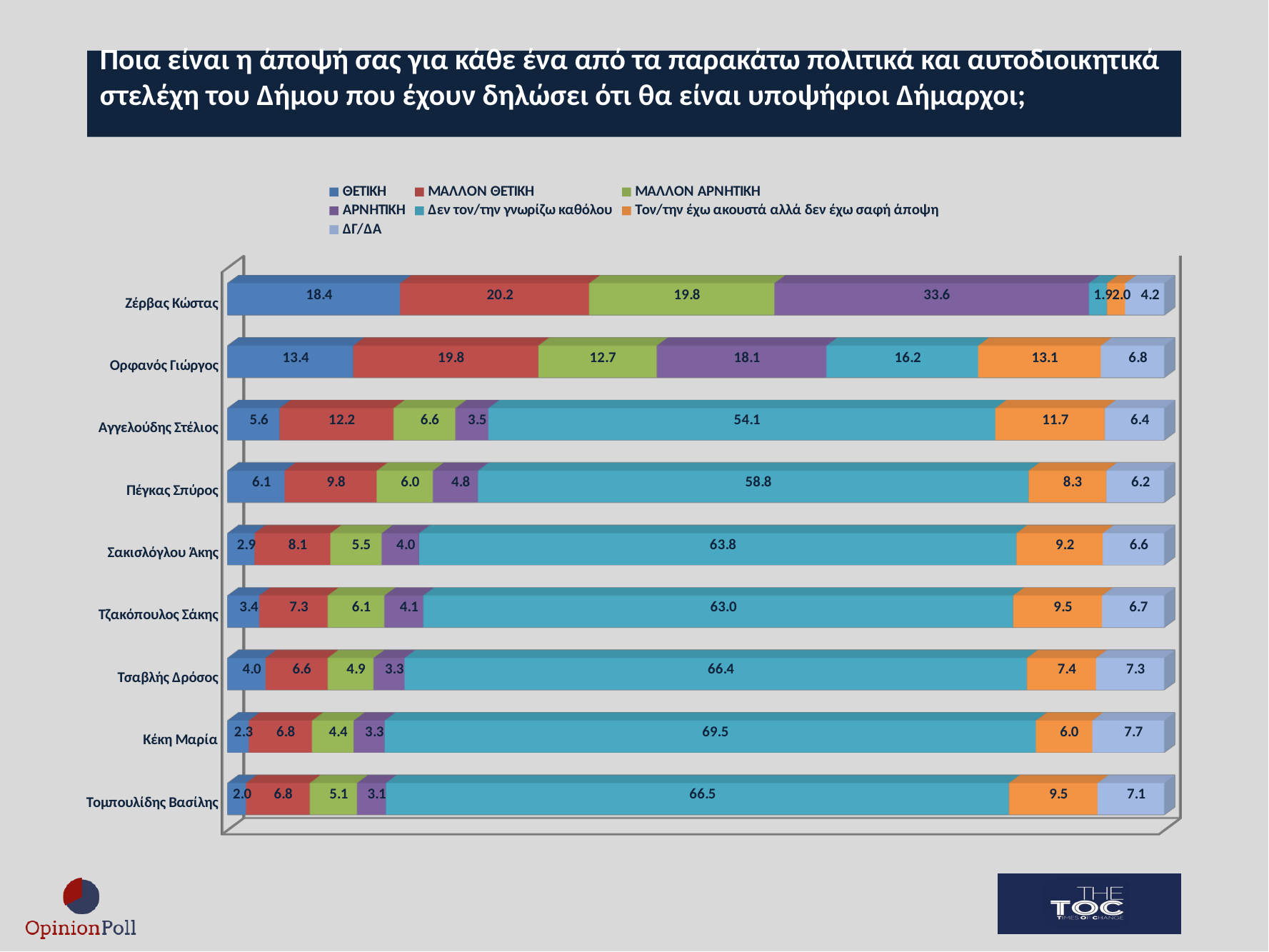
Which is larger: the ΜΑΛΛΟΝ ΘΕΤΙΚΗ value for Αγγελούδης Στέλιος or for Πέγκας Σπύρος? Αγγελούδης Στέλιος Which candidate has the highest ΘΕΤΙΚΗ value? Ζέρβας Κώστας How many series does the legend list? 7 Which candidate has the lowest ΘΕΤΙΚΗ value? Τομπουλίδης Βασίλης What is the ΘΕΤΙΚΗ value for Ζέρβας Κώστας? 18.4 What is the difference between the ΑΡΝΗΤΙΚΗ values for Ζέρβας Κώστας and Ορφανός Γιώργος? 15.5 Which colour represents the ΔΓ/ΔΑ series in the legend? Light blue What kind of chart is shown on the slide? Stacked bar chart What is the 'Δεν τον/την γνωρίζω καθόλου' value for Πέγκας Σπύρος? 58.8 What is the ΑΡΝΗΤΙΚΗ value for Ορφανός Γιώργος? 18.1 How many candidates are shown in the chart? 9 Which candidate has the highest 'Δεν τον/την γνωρίζω καθόλου' value? Κέκη Μαρία